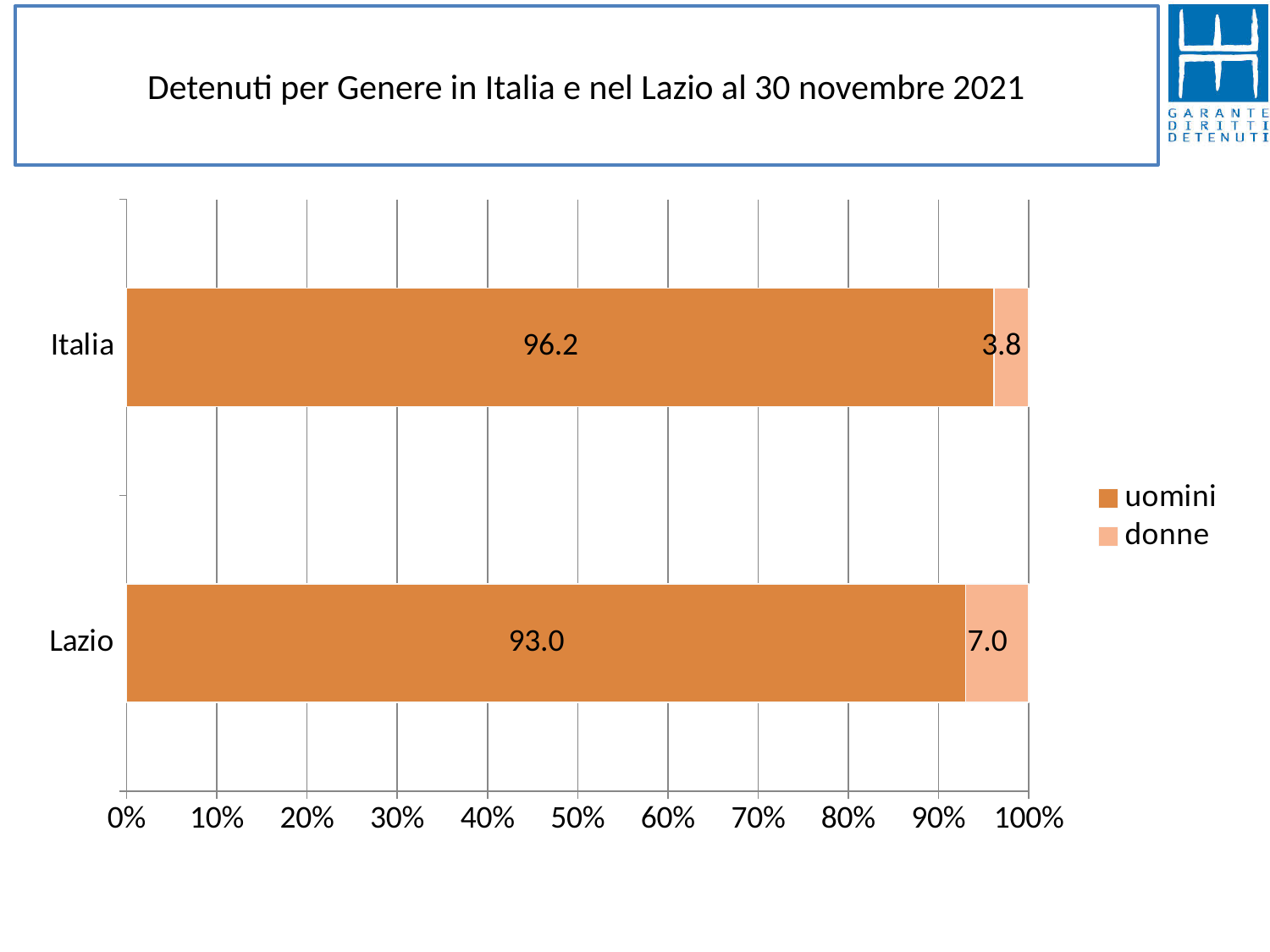
What kind of chart is shown on the slide? Stacked bar chart Which category has the higher value for donne, Italia or Lazio? Lazio What is the difference between the uomini values for Italia and Lazio? 3.2 Which category has the lowest value for uomini? Lazio How many categories are shown on the chart? 2 How many series does the legend list? 2 What is the value for donne in Lazio? 7.0 What is the value for uomini in Italia? 96.2 Is the value for uomini in Lazio greater or less than 90%? greater What is the difference between the donne values for Lazio and Italia? 3.2 What is the value for uomini in Lazio? 93.0 What is the value for donne in Italia? 3.8